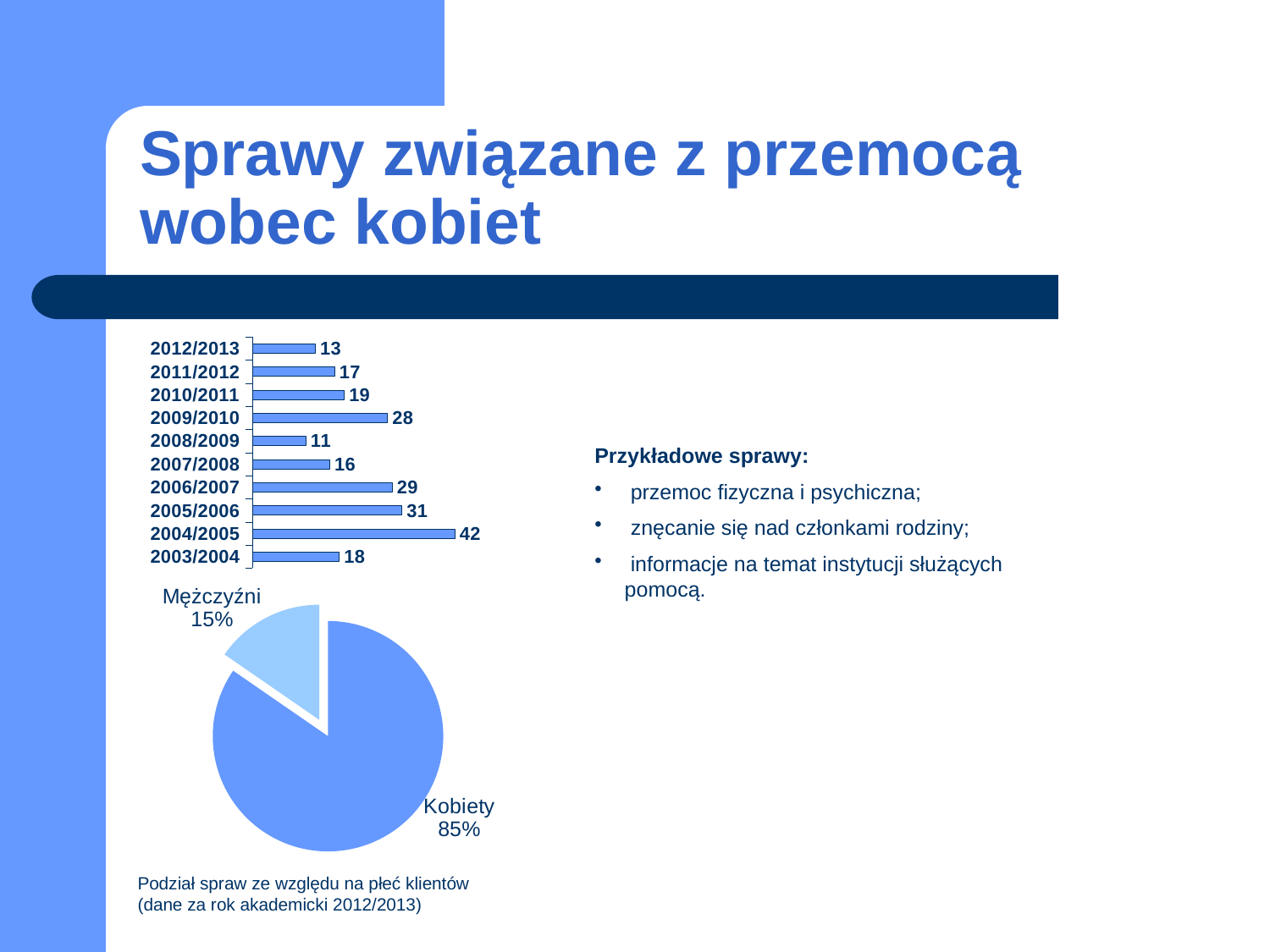
In the bar chart at the top left, what is the difference between the values for 2005/2006 and 2006/2007? 2 In the pie chart at the bottom left, what share is labelled Kobiety? 85% In the bar chart at the top left, which academic year has the lowest value? 2008/2009 In the pie chart at the bottom left, how many slices are there? 2 In the bar chart at the top left, which is larger, the value for 2009/2010 or the value for 2010/2011? 2009/2010 In the bar chart at the top left, which academic year has the highest value? 2004/2005 In the bar chart at the top left, what is the value for 2012/2013? 13 What kind of chart is shown at the top left of the slide? Bar chart In the pie chart at the bottom left, what share is labelled Mężczyźni? 15% In the bar chart at the top left, how many academic years are shown? 10 In the bar chart at the top left, what is the value for 2004/2005? 42 What caption appears below the pie chart at the bottom left? Podział spraw ze względu na płeć klientów (dane za rok akademicki 2012/2013)